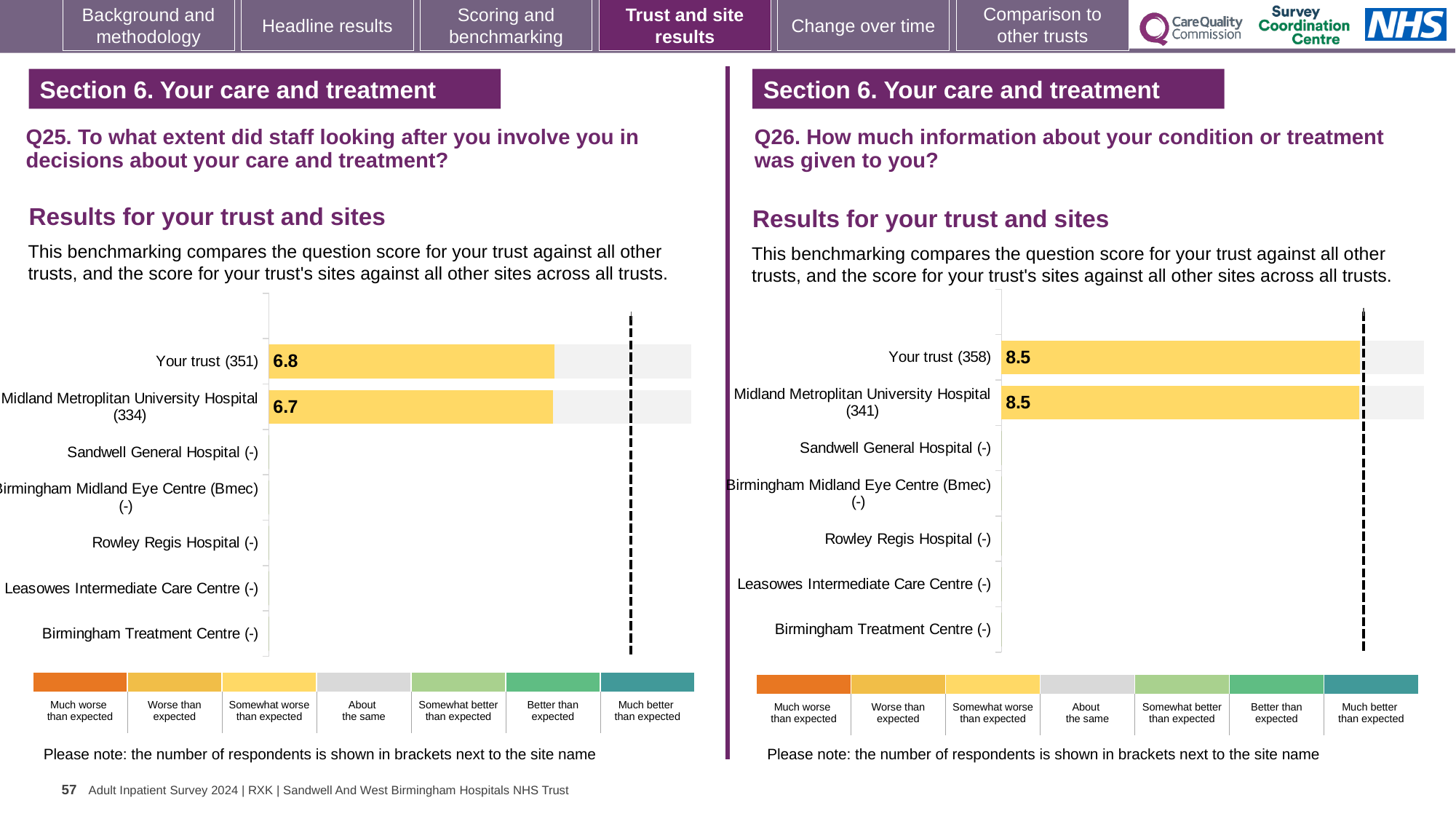
On the Q25 chart (left), what is the score for Midland Metroplitan University Hospital? 6.7 On the Q25 chart (left), what is the score for Your trust? 6.8 On the Q26 chart (right), how many respondents are shown in brackets for Your trust? 358 What kind of chart is the Q25 chart on the left? Bar chart On the Q26 chart (right), what is the score for Your trust? 8.5 On the Q25 chart (left), how many site or trust categories are listed on the vertical axis? 7 On the Q26 chart (right), what is the score for Midland Metroplitan University Hospital? 8.5 On the Q25 chart (left), how many respondents are shown in brackets for Midland Metroplitan University Hospital? 334 On the Q25 chart (left), what is the difference between the score for Your trust and the score for Midland Metroplitan University Hospital? 0.1 On the Q26 chart (right), which benchmark category does the colour of the bars correspond to according to the legend? Somewhat worse than expected How many categories does the colour legend below the Q25 chart (left) list? 7 On the Q26 chart (right), what is the difference between the score for Your trust and the score for Midland Metroplitan University Hospital? 0